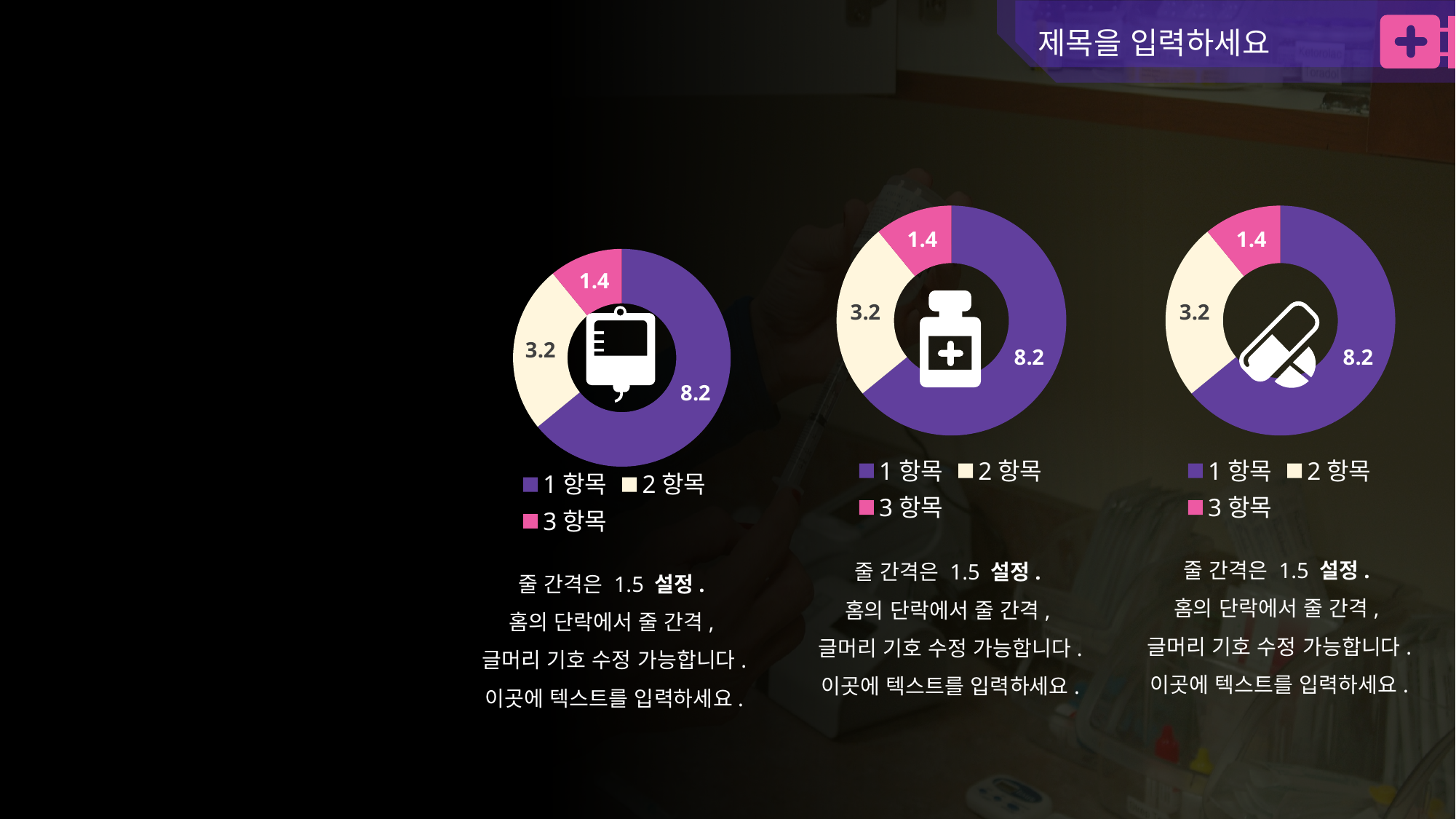
In the right chart, what is the value for 3 항목? 1.4 In the right chart, which is larger, the value for 2 항목 or the value for 3 항목? 2 항목 In the left chart, what colour is the slice for 3 항목? pink In the left chart, what is the value for 1 항목? 8.2 How many categories does the middle chart show? 3 In the left chart, what is the difference between the values for 2 항목 and 3 항목? 1.8 In the right chart, which category has the smallest value? 3 항목 In the middle chart, what is the difference between the values for 1 항목 and 2 항목? 5.0 In the left chart, which category has the largest value? 1 항목 How many entries does the legend of the right chart list? 3 In the middle chart, what is the value for 2 항목? 3.2 What kind of chart is the left chart on the slide? doughnut chart